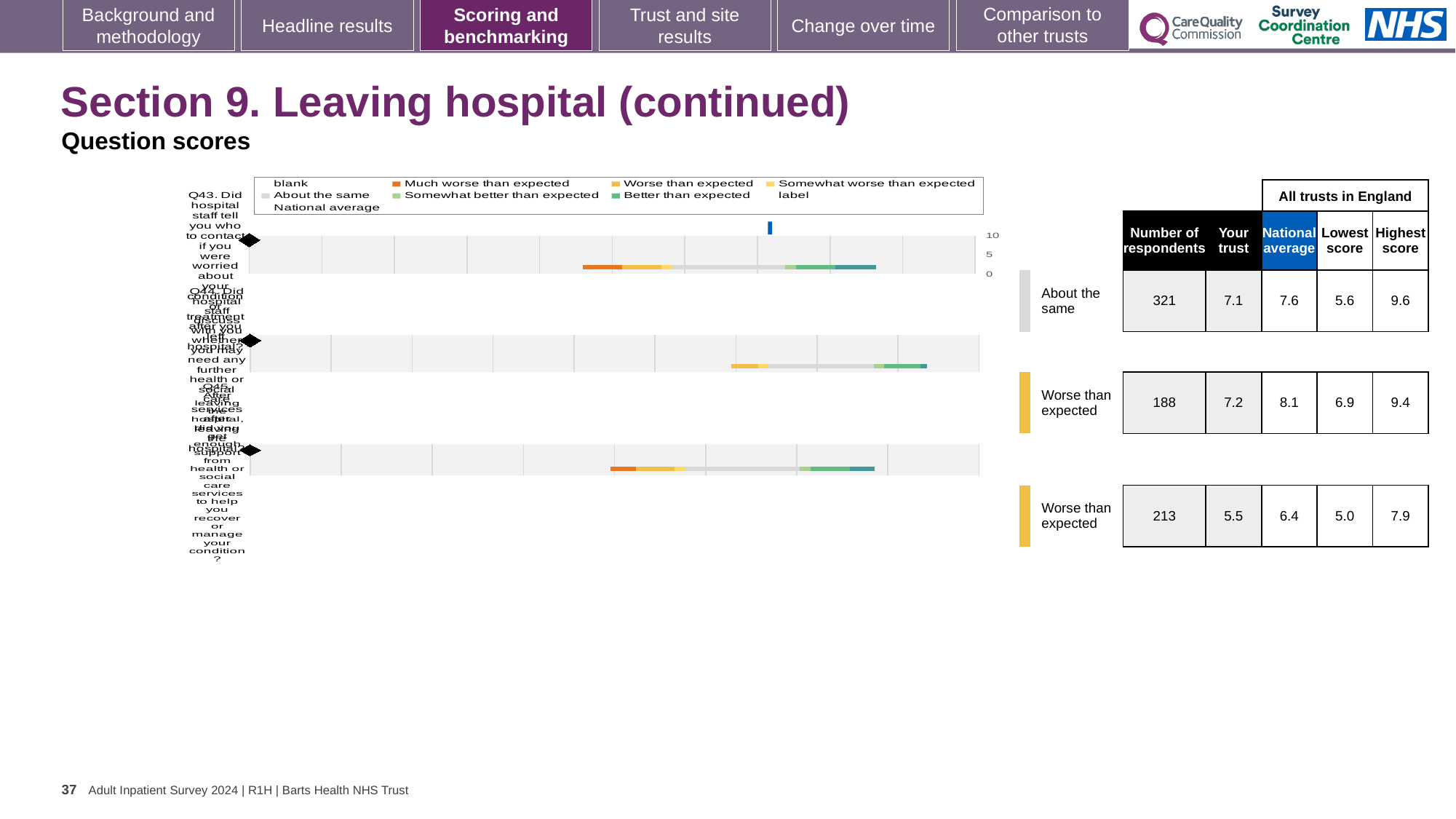
Which question has the lowest 'Your trust' score? Q45 What kind of chart is used to show the question scores on this slide? bar chart What is the national average score for Q44? 8.1 What is the highest score across all trusts in England for Q44? 9.4 What is the 'Your trust' score for Q43? 7.1 For Q43, which is larger: the 'Your trust' score or the national average? National average For Q45, what is the difference between the national average and the 'Your trust' score? 0.9 How many questions (rows) are plotted in the chart? 3 Which legend entry is shown in orange? Much worse than expected What is the lowest score across all trusts in England for Q45? 5.0 How many respondents are listed for Q43? 321 What benchmark category is Q43 placed in? About the same